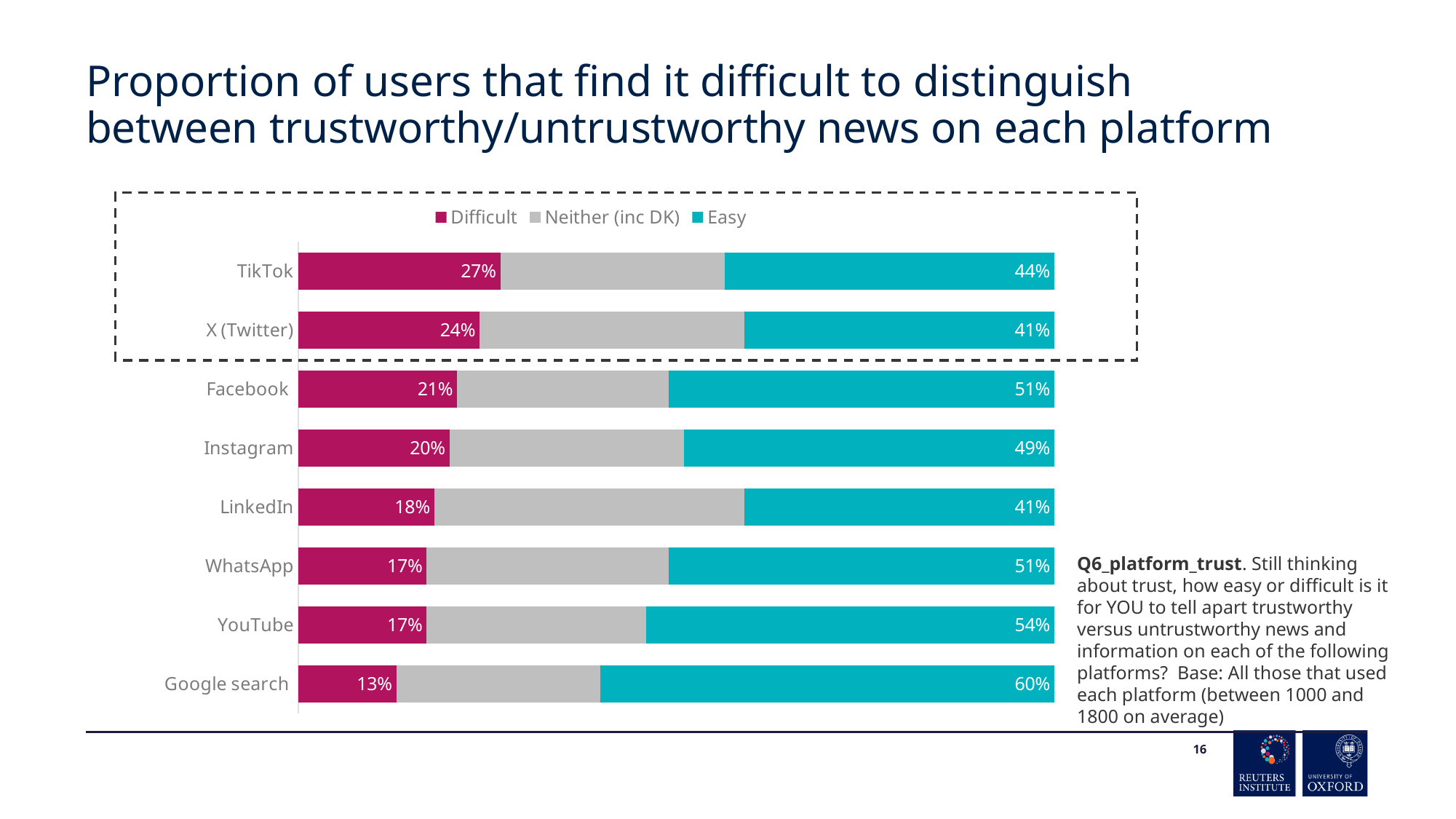
Which platform has the lowest 'Difficult' percentage? Google search How many series does the legend list? 3 Which has a larger 'Easy' value, Facebook or Instagram? Facebook What is the difference between the 'Easy' values for YouTube and LinkedIn? 13% What percentage of TikTok users find it difficult to distinguish trustworthy from untrustworthy news? 27% Which platform has the highest 'Easy' percentage? Google search What is the difference between the 'Difficult' values for TikTok and X (Twitter)? 3% How many platforms are shown in the chart? 8 What is the 'Difficult' value for LinkedIn? 18% Which platform has the highest 'Difficult' percentage? TikTok What is the 'Easy' value for Google search? 60% What type of chart is shown on the slide? Stacked bar chart